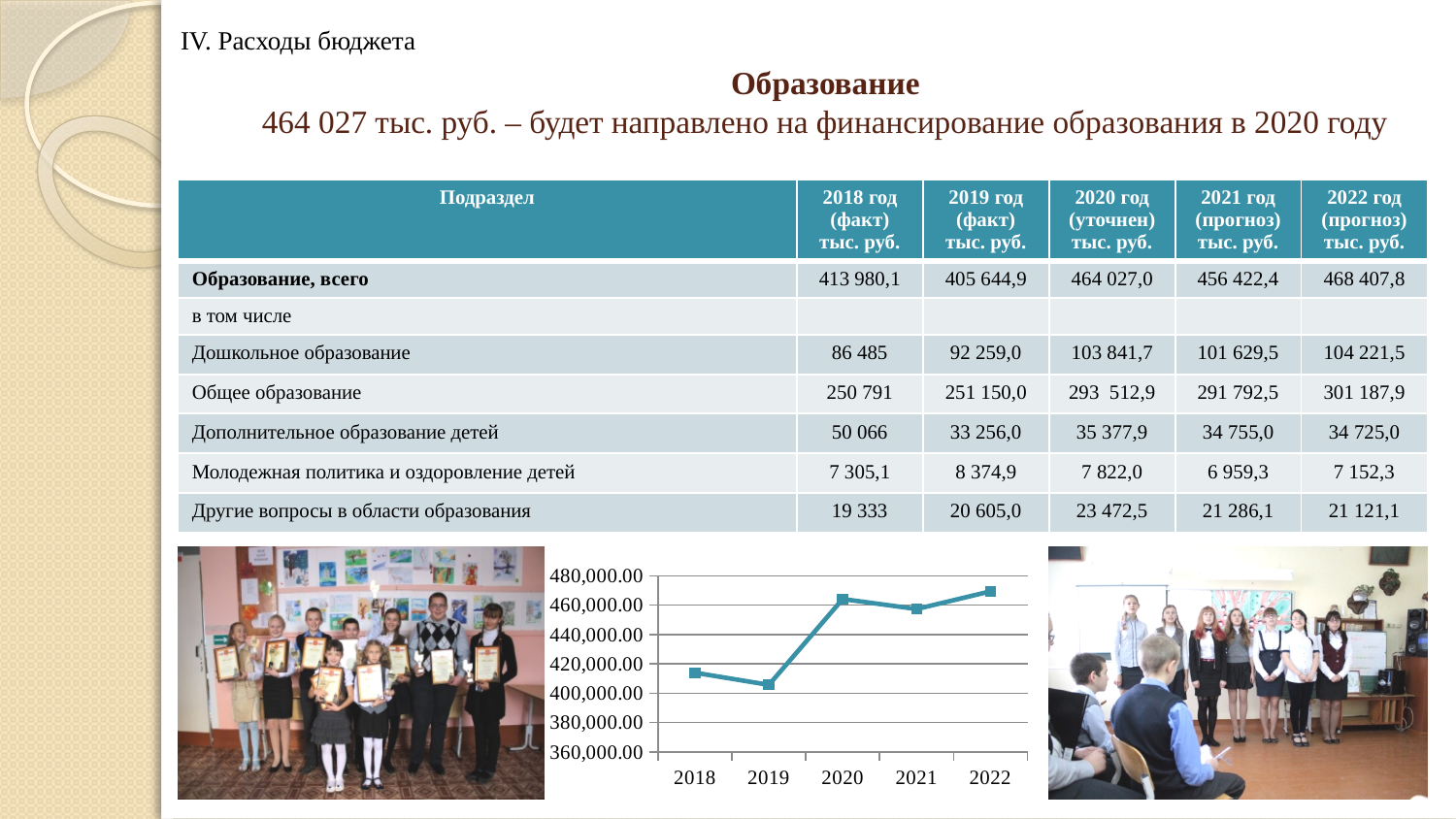
On the line chart, is the value for 2022 greater or less than 480,000.00? less On the line chart, is the value for 2020 greater or less than 460,000.00? greater On the line chart, is the value for 2019 greater or less than 400,000.00? greater On the line chart, which year has the larger value, 2020 or 2021? 2020 How many data points are plotted on the line chart? 5 Which year has the highest value on the line chart? 2022 What kind of chart is shown at the bottom of the slide? line chart Which year has the lowest value on the line chart? 2019 Overall, do the values on the line chart rise or fall from 2018 to 2022? rise On the line chart, which year has the larger value, 2018 or 2019? 2018